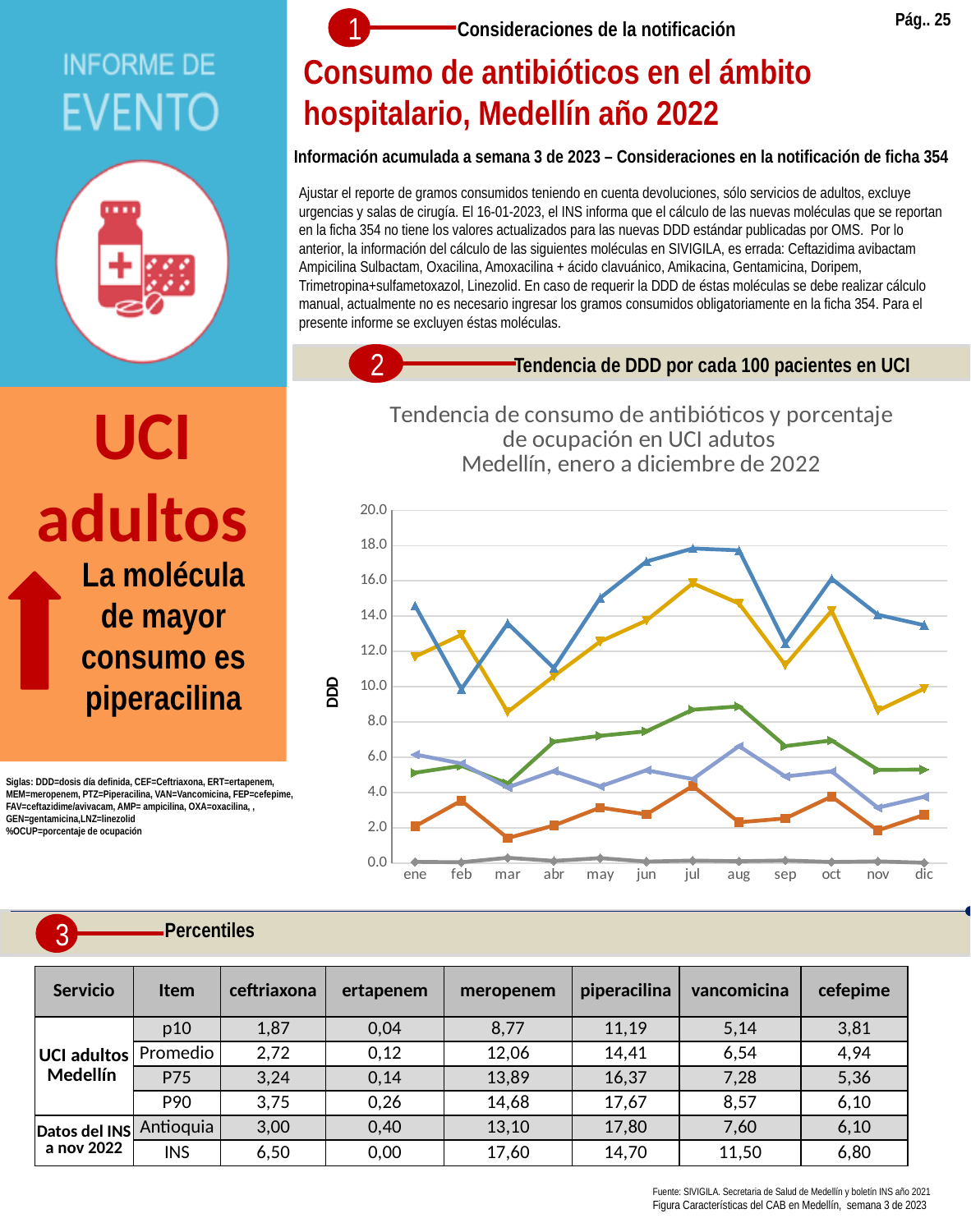
Is the lowest value plotted in mar on the line chart greater or less than 2.0? less Does the topmost line on the chart rise or fall from abr to jul? rise What is the highest tick value shown on the y axis of the line chart? 20.0 What is the label of the y axis of the line chart? DDD What kind of chart is shown under 'Tendencia de DDD por cada 100 pacientes en UCI'? line chart Does the topmost line on the chart rise or fall from oct to dic? fall How many months are plotted along the x axis of the line chart? 12 What is the first month shown on the x axis of the line chart? ene Is the highest value plotted in jul on the line chart greater or less than 16.0? greater Is the highest value plotted in feb on the line chart greater or less than 14.0? less What is the last month shown on the x axis of the line chart? dic